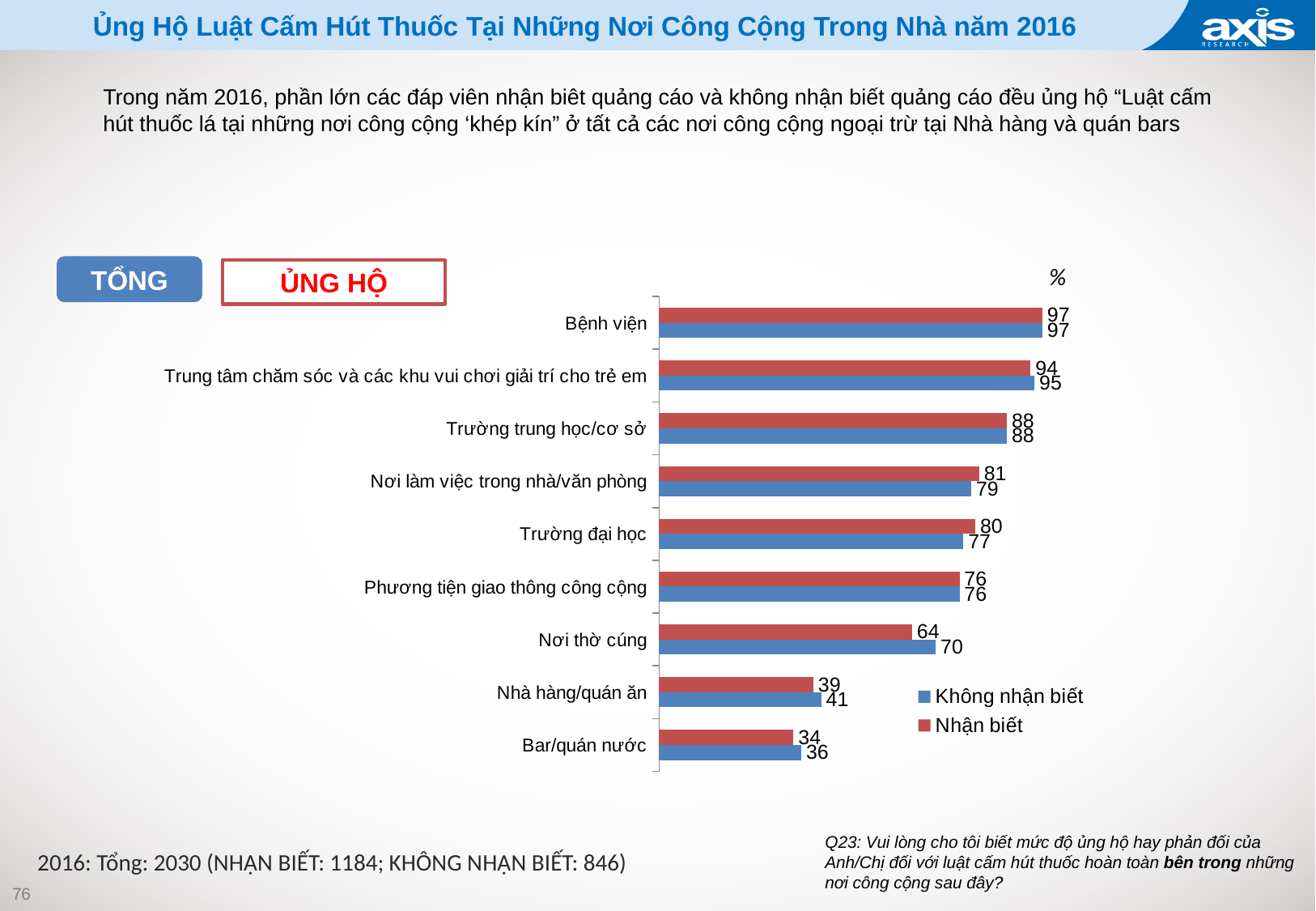
What is the value for "Nhận biết" at "Nơi thờ cúng"? 64 What is the value for "Không nhận biết" at "Nhà hàng/quán ăn"? 41 At "Nơi làm việc trong nhà/văn phòng", which series has the larger value, "Nhận biết" or "Không nhận biết"? Nhận biết How many categories (locations) are plotted in the chart? 9 Which category has the highest value for "Không nhận biết"? Bệnh viện What is the difference between the "Nhận biết" values for "Bệnh viện" and "Bar/quán nước"? 63 Which series is shown in red in the chart? Nhận biết How many series does the legend list? 2 What is the value for "Nhận biết" at "Trường đại học"? 80 Which category has the lowest value for "Nhận biết"? Bar/quán nước What is the difference between the "Không nhận biết" and "Nhận biết" values at "Nơi thờ cúng"? 6 What kind of chart is shown on the slide? bar chart